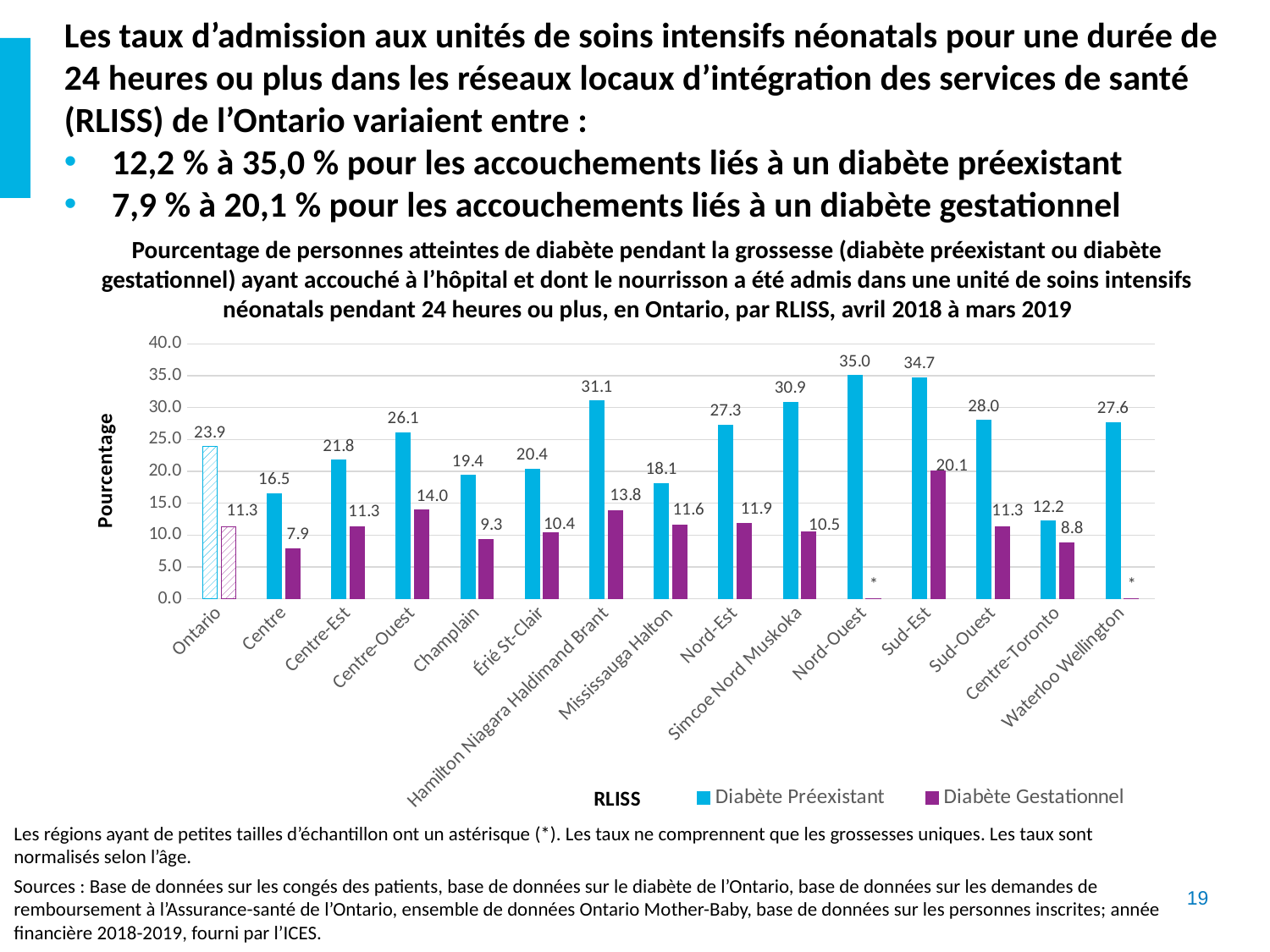
Which is larger for Diabète Préexistant: Simcoe Nord Muskoka or Nord-Est? Simcoe Nord Muskoka Which RLISS has the highest value for Diabète Préexistant? Nord-Ouest What is the difference between the Diabète Préexistant and Diabète Gestationnel values for Sud-Est? 14.6 Which RLISS has the lowest value for Diabète Gestationnel? Centre What is the value for Diabète Préexistant in Hamilton Niagara Haldimand Brant? 31.1 How many series does the legend list? 2 How many categories are shown on the x axis? 15 Which RLISS has the highest value for Diabète Gestationnel? Sud-Est Which RLISS has the lowest value for Diabète Préexistant? Centre-Toronto What is the value for Diabète Préexistant for Ontario overall? 23.9 What type of chart is shown on the slide? Bar chart What is the value for Diabète Gestationnel in Centre-Ouest? 14.0